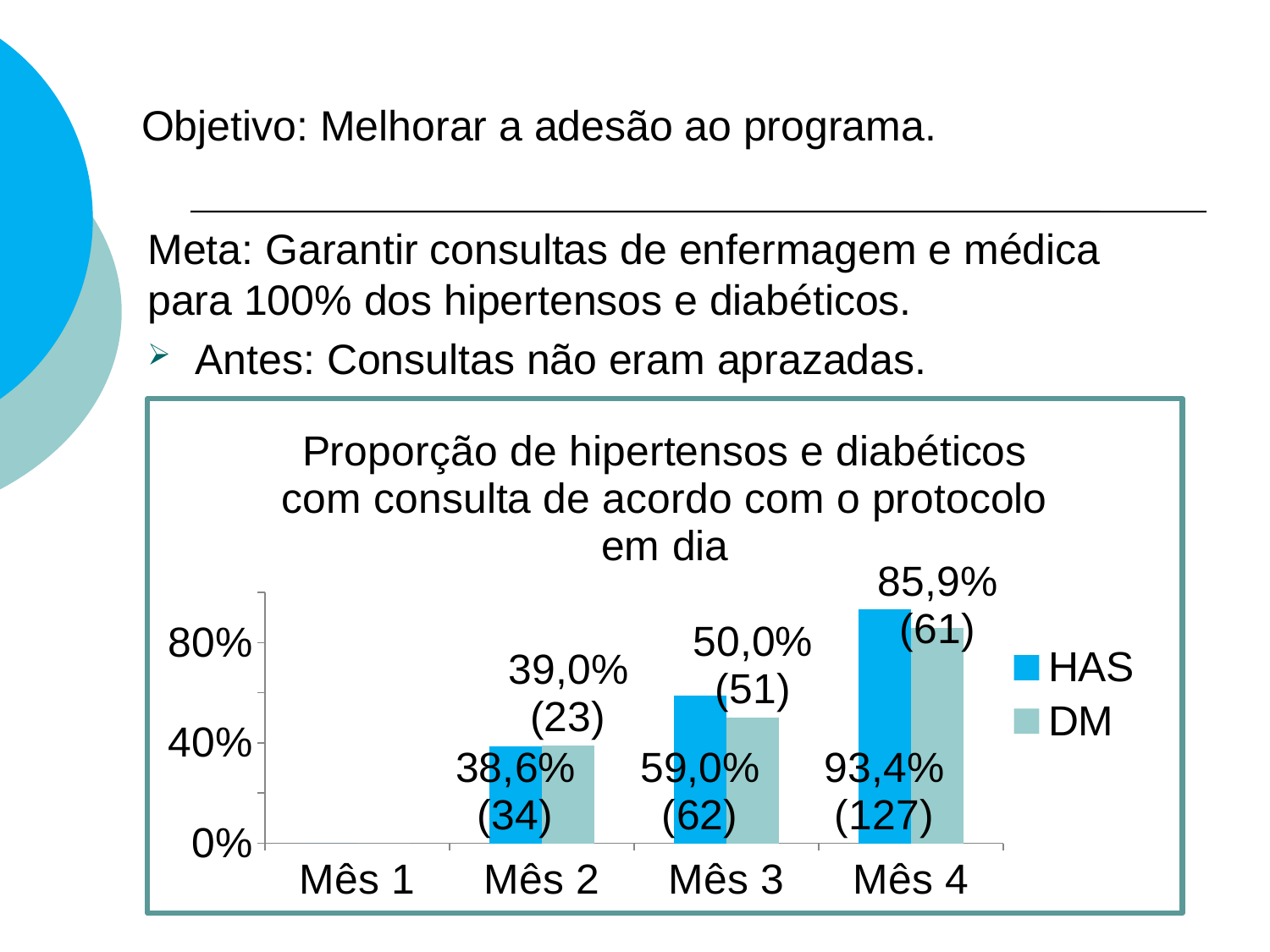
Which series has the larger value in Mês 3, HAS or DM? HAS Is the HAS value for Mês 4 greater or less than 80%? greater How many series does the legend list? 2 What is the HAS value for Mês 4? 93,4% How many month categories are shown on the x axis? 4 In which month is the HAS value highest? Mês 4 What is the DM value for Mês 2? 39,0% What type of chart is shown on the slide? bar chart What is the DM value for Mês 3? 50,0% What count is shown in parentheses for HAS in Mês 3? 62 What is the difference between the HAS and DM values in Mês 4? 7,5% Do the HAS values rise or fall from Mês 2 to Mês 4? rise